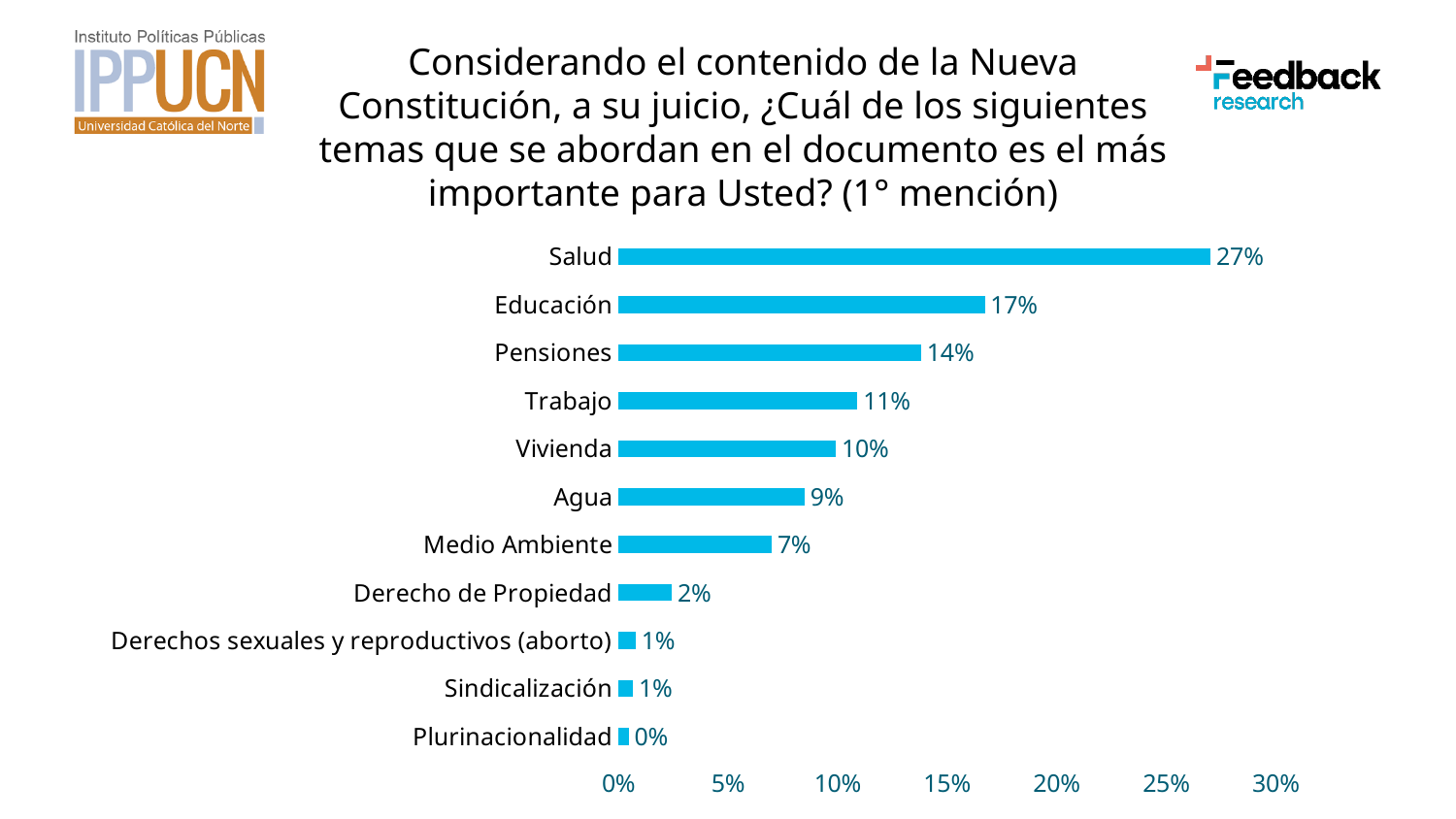
What is the value for Pensiones? 14% Which category has the lowest value? Plurinacionalidad What kind of chart is shown on the slide? Bar chart How many categories are shown in the chart? 11 What is the value for Plurinacionalidad? 0% What is the value for Salud? 27% What is the difference between the values for Salud and Educación? 10% What is the highest value shown on the horizontal axis? 30% Which category has the highest value? Salud What is the value for Medio Ambiente? 7% What is the difference between the values for Trabajo and Agua? 2% Which is larger, the value for Vivienda or the value for Medio Ambiente? Vivienda